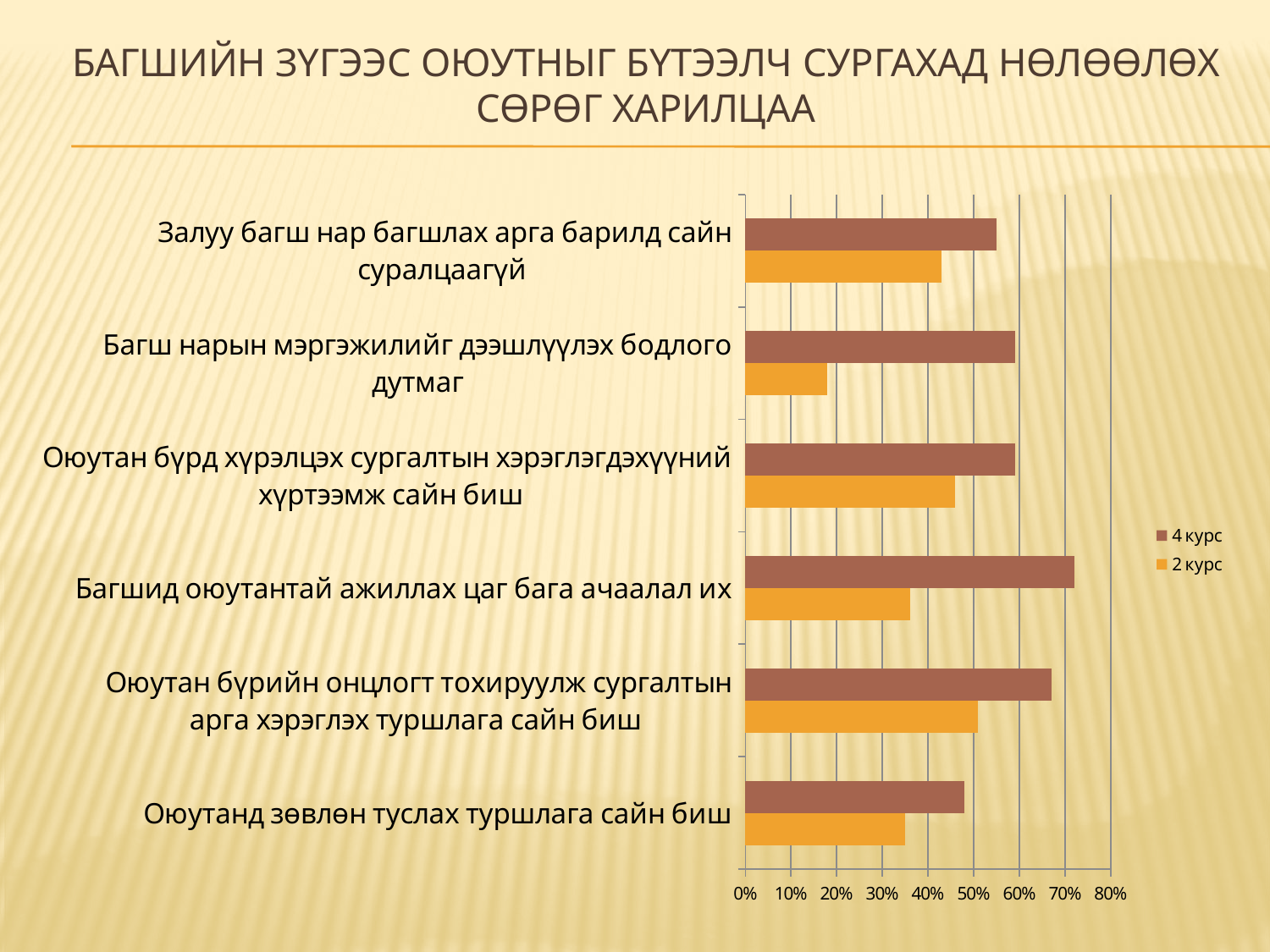
Is the 2 курс value for "Багш нарын мэргэжилийг дээшлүүлэх бодлого дутмаг" greater or less than 20%? less Is the 4 курс value for "Багшид оюутантай ажиллах цаг бага ачаалал их" greater or less than 60%? greater What kind of chart is shown on the slide? bar chart How many series does the legend list? 2 For "Залуу багш нар багшлах арга барилд сайн суралцаагүй", which series has the larger value, 4 курс or 2 курс? 4 курс Which category has the highest value for the 4 курс series? Багшид оюутантай ажиллах цаг бага ачаалал их What are the two series names listed in the legend? 4 курс and 2 курс For "Багшид оюутантай ажиллах цаг бага ачаалал их", which series has the larger value, 4 курс or 2 курс? 4 курс Is the 4 курс value for "Оюутанд зөвлөн туслах туршлага сайн биш" greater or less than 60%? less Which category has the lowest value for the 4 курс series? Оюутанд зөвлөн туслах туршлага сайн биш Which category has the lowest value for the 2 курс series? Багш нарын мэргэжилийг дээшлүүлэх бодлого дутмаг How many categories are plotted on the chart? 6